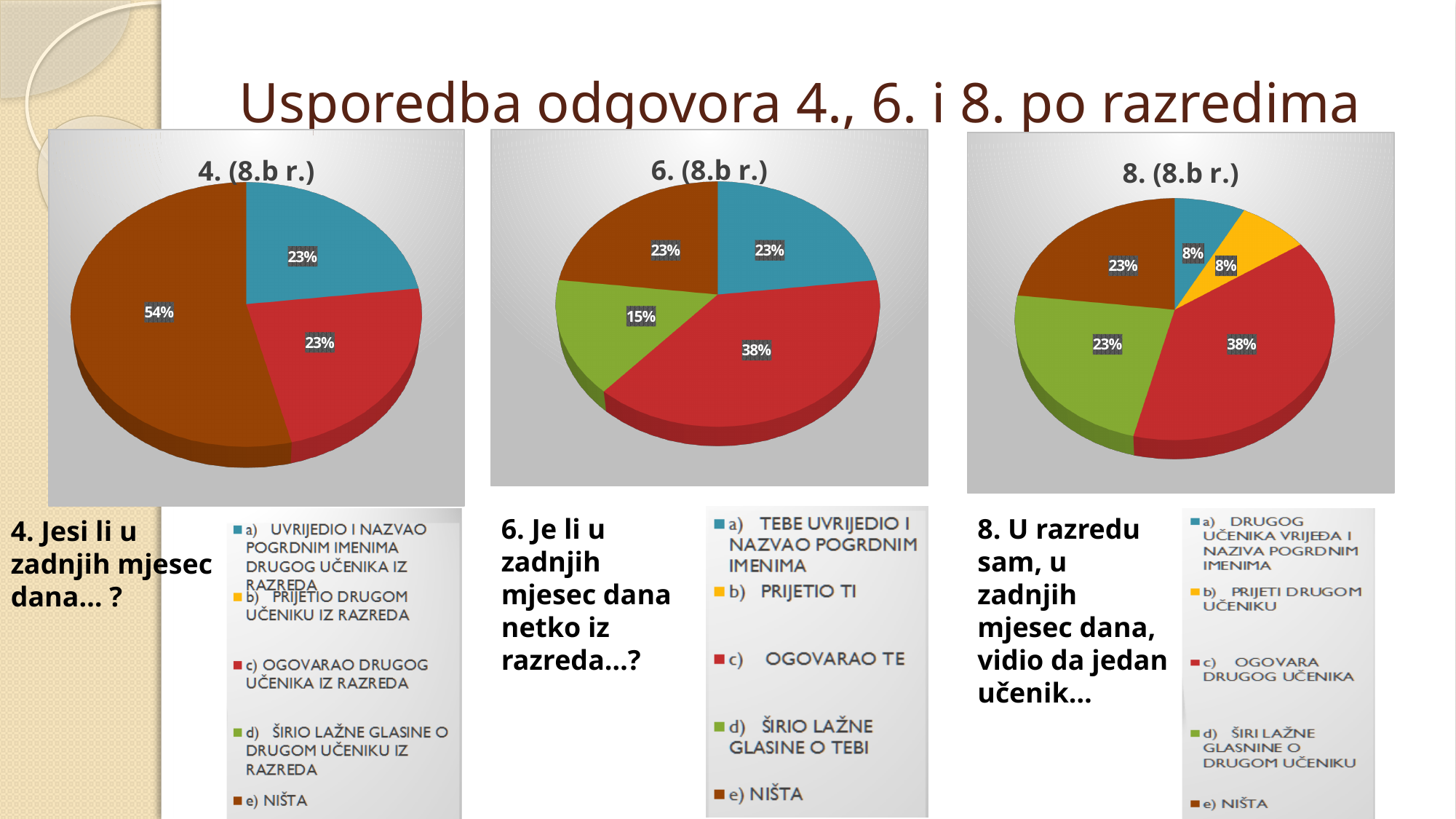
In the chart "8. (8.b r.)", what share is shown for the yellow slice (b) PRIJETI DRUGOM UČENIKU)? 8% In the chart "8. (8.b r.)", which answer has the largest slice? c) OGOVARA DRUGOG UČENIKA In the chart "4. (8.b r.)", which answer has the largest slice? e) NIŠTA How many slices does the pie chart "4. (8.b r.)" have? 3 How many slices does the pie chart "8. (8.b r.)" have? 5 How many slices does the pie chart "6. (8.b r.)" have? 4 In the chart "6. (8.b r.)", what share is shown for the red slice (c) OGOVARAO TE)? 38% In the chart "6. (8.b r.)", what is the difference in percentage points between the red slice (38%) and the green slice (15%)? 23 percentage points What type of chart is used for "4. (8.b r.)"? pie chart In the chart "8. (8.b r.)", which slice is larger: the green slice (d) or the blue slice (a)? the green slice (d) In the chart "6. (8.b r.)", which answer has the smallest slice? d) ŠIRIO LAŽNE GLASINE O TEBI In the chart "4. (8.b r.)", what share is shown for the brown slice (e) NIŠTA)? 54%